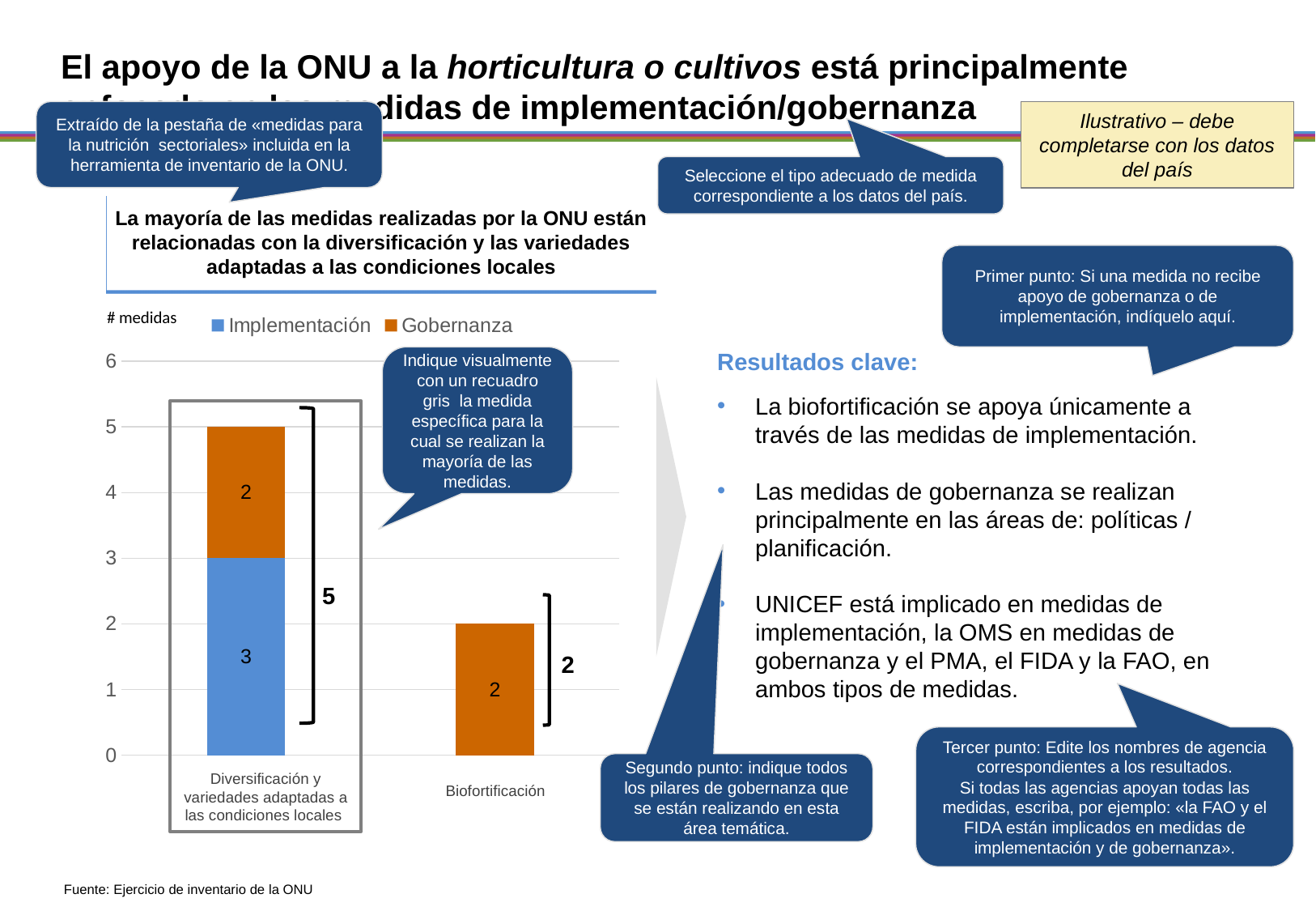
Which category has the highest total number of measures? Diversificación y variedades adaptadas a las condiciones locales What is the total number of measures for 'Biofortificación'? 2 Which category has the lowest total number of measures? Biofortificación What is the total number of measures for 'Diversificación y variedades adaptadas a las condiciones locales'? 5 What is the Implementación value for 'Diversificación y variedades adaptadas a las condiciones locales'? 3 What is the label of the vertical axis of the chart? # medidas How many categories are shown on the x axis of the chart? 2 What is the difference between the total for 'Diversificación y variedades adaptadas a las condiciones locales' and the total for 'Biofortificación'? 3 How many series does the chart legend list? 2 What is the Gobernanza value for 'Diversificación y variedades adaptadas a las condiciones locales'? 2 Which series is shown in blue in the chart legend? Implementación What type of chart is shown on the slide? Stacked bar chart